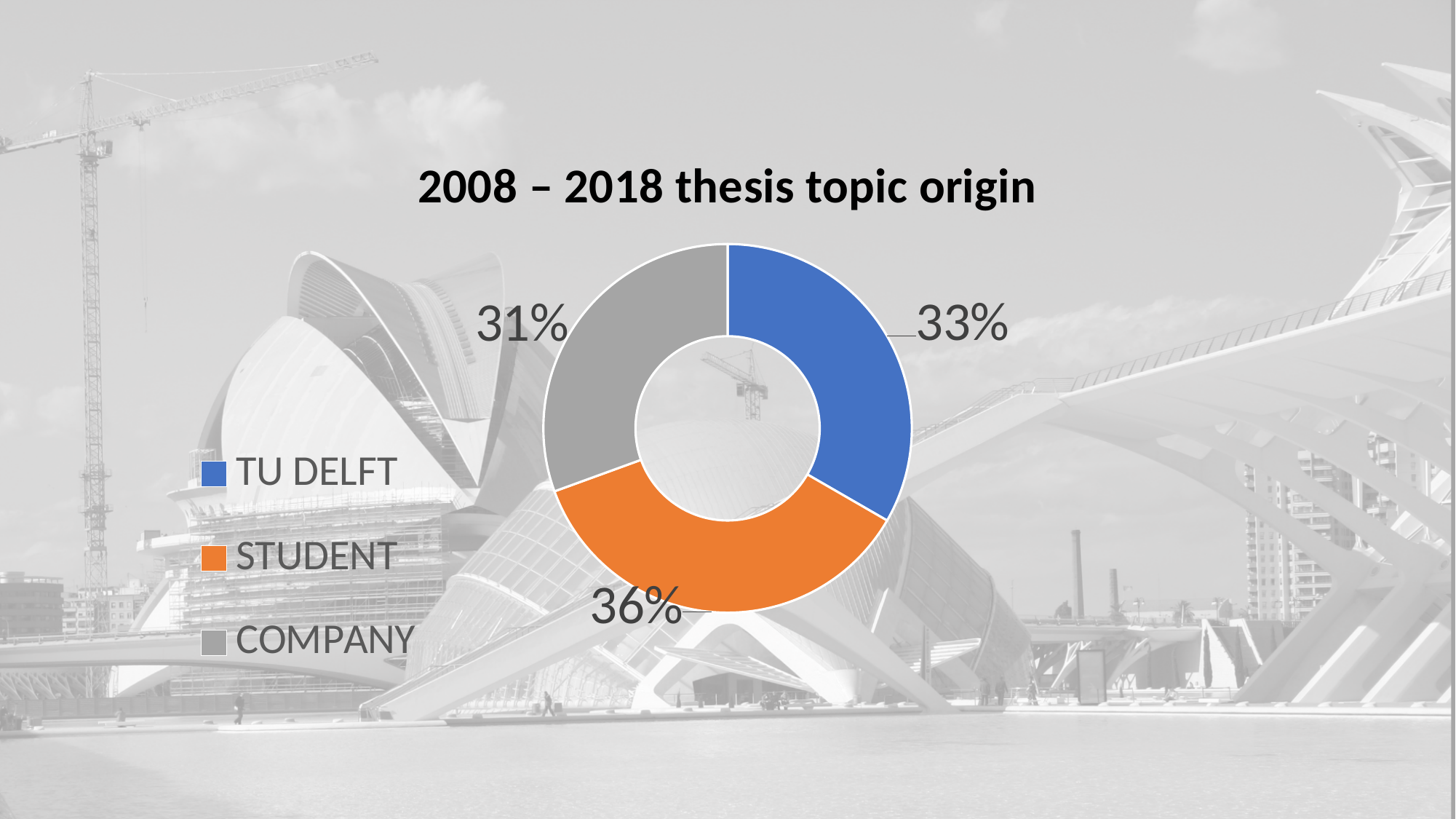
What share of thesis topics originated from companies? 31% Which thesis topic origin has the largest share? STUDENT Which colour represents COMPANY in the chart? Grey What share of thesis topics originated from TU Delft? 33% Which has a larger share, TU DELFT or STUDENT? STUDENT What share of thesis topics originated from students? 36% What is the difference in percentage points between the STUDENT share and the COMPANY share? 5 What kind of chart is shown on the slide? Doughnut (pie) chart What is the title of the chart? 2008 – 2018 thesis topic origin Which thesis topic origin has the smallest share? COMPANY What is the difference in percentage points between the TU DELFT share and the COMPANY share? 2 How many categories does the chart show? 3